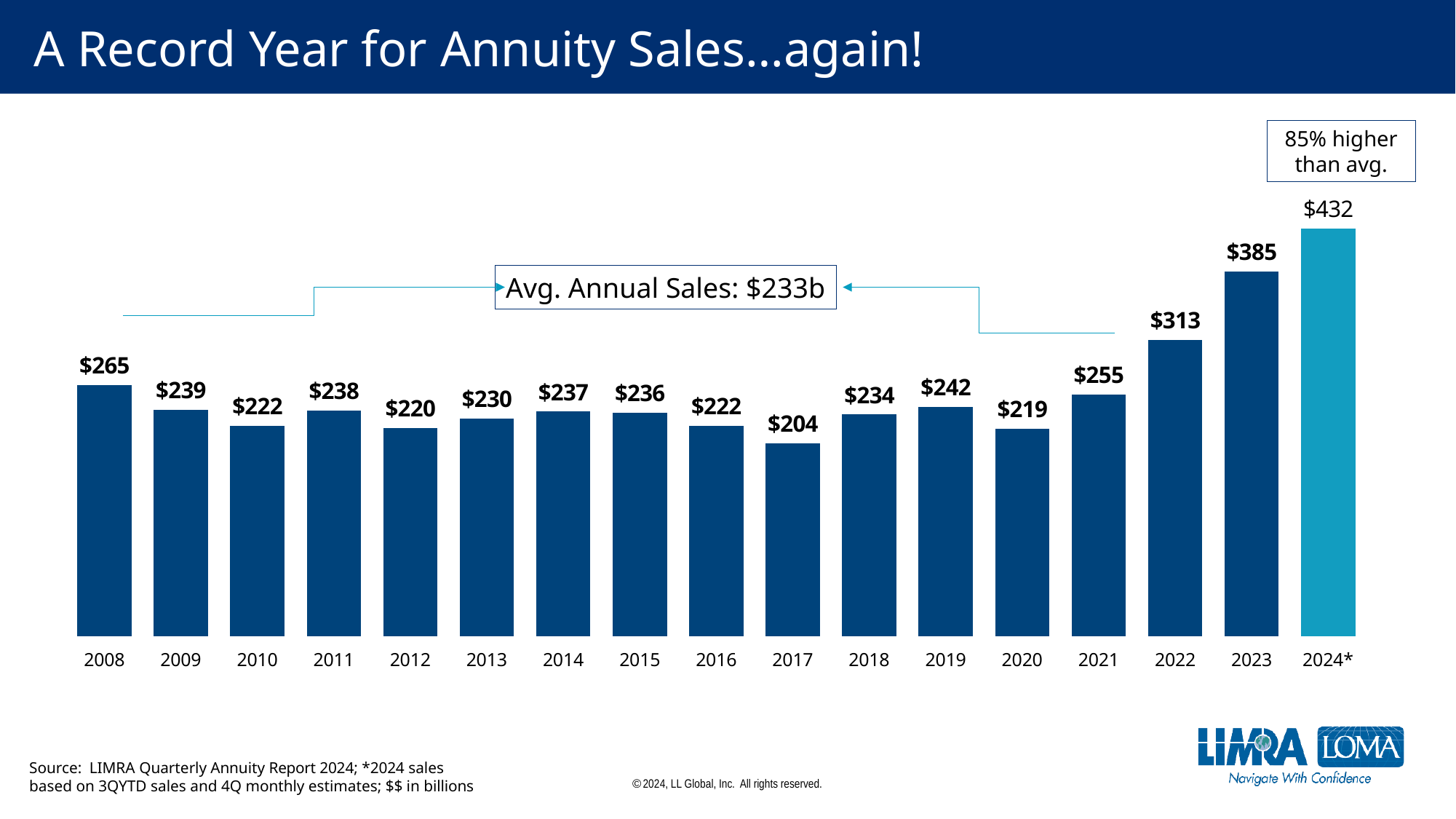
Do the annuity sales values rise or fall from 2020 to 2024*? Rise What kind of chart is shown on the slide? Bar chart What is the annuity sales value shown for 2017? $204 What is the annuity sales value shown for 2024*? $432 What is the difference between the 2024* value and the 2023 value? $47 How many years are shown on the x axis of the chart? 17 Which is larger, the value for 2008 or the value for 2021? 2008 What average annual sales figure is stated in the callout box on the chart? $233b Which year has the lowest annuity sales value? 2017 What is the difference between the 2022 value and the 2021 value? $58 What is the annuity sales value shown for 2008? $265 Which year has the highest annuity sales value? 2024*